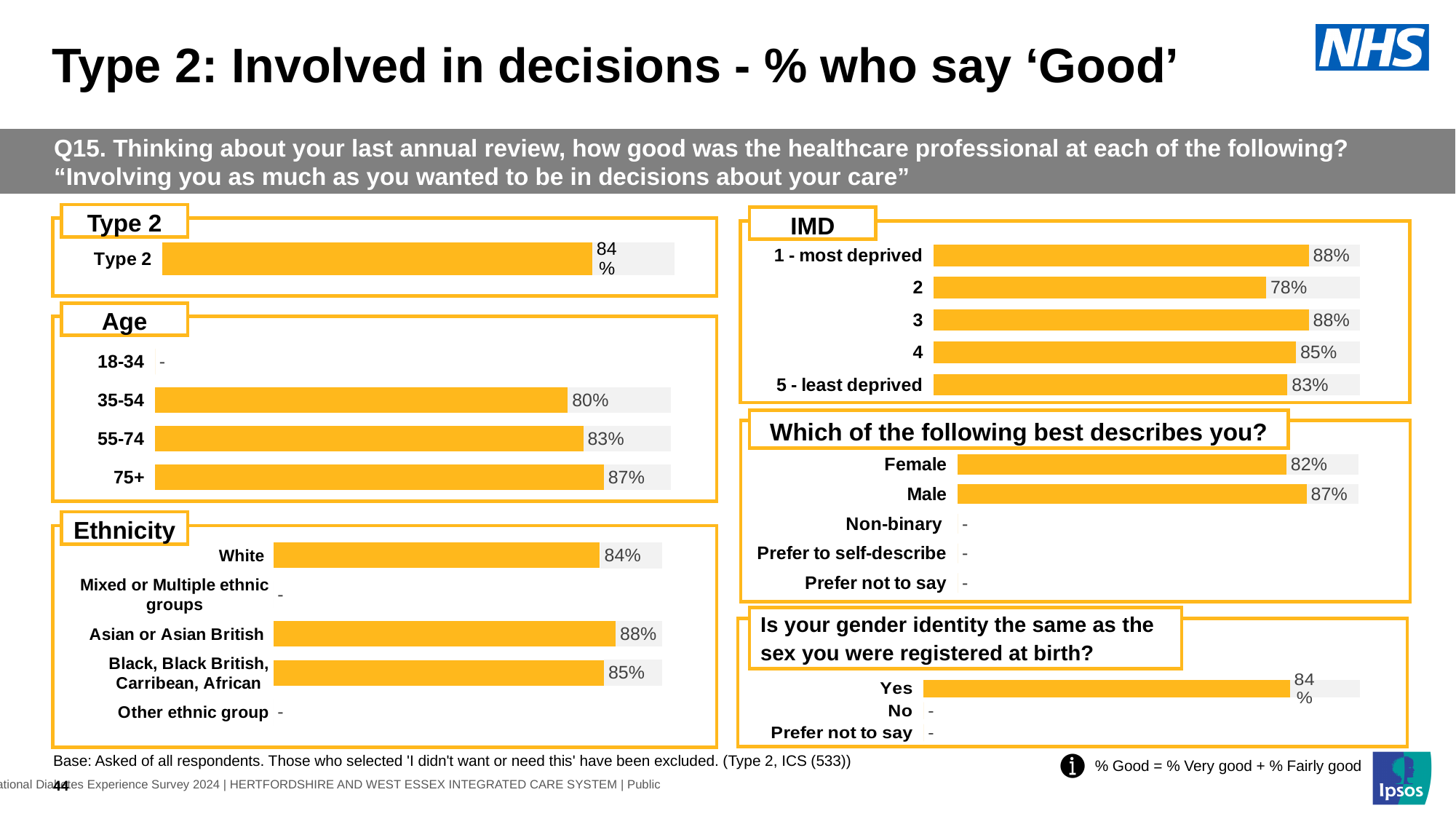
In the Ethnicity chart, which ethnic group has the highest value? Asian or Asian British In the IMD chart, what is the value for 5 - least deprived? 83% In the Type 2 chart, what is the value for Type 2? 84% In the Ethnicity chart, what is the value for Black, Black British, Carribean, African? 85% In the IMD chart, which category has the lowest value? 2 In the Age chart, what is the value for 35-54? 80% In the Age chart, which age group has the highest value? 75+ In the 'Which of the following best describes you?' chart, which is larger, the value for Female or Male? Male In the Age chart, what is the difference between the values for 75+ and 55-74? 4 percentage points In the 'Is your gender identity the same as the sex you were registered at birth?' chart, what is the value for Yes? 84% In the IMD chart, how many categories are shown? 5 What type of chart is used in the IMD section? Bar chart